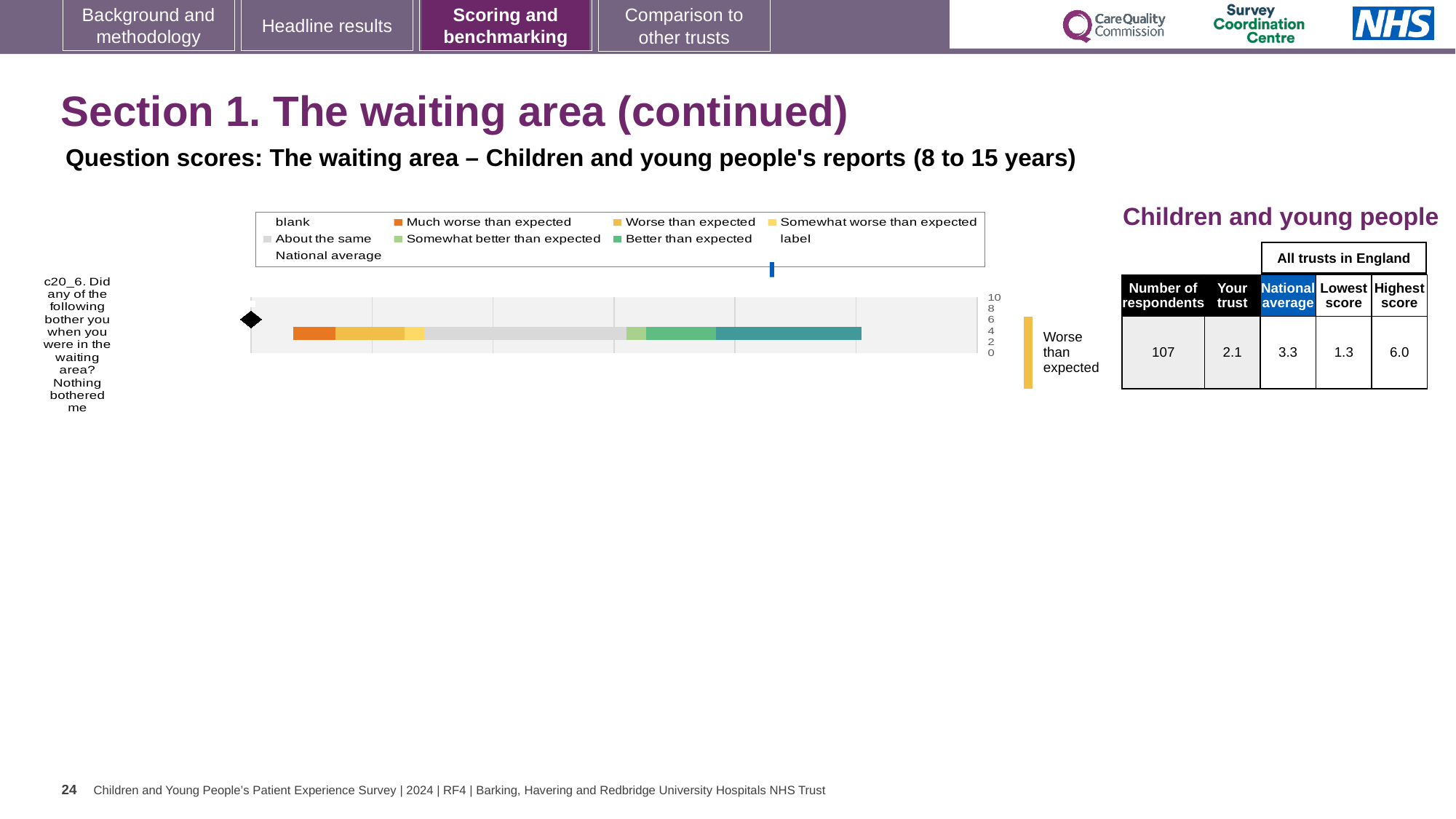
In the table next to the chart, what is the Number of respondents for question c20_6? 107 What benchmark label is shown to the right of the chart for question c20_6? Worse than expected What is the highest tick value shown on the chart's axis? 10 In the table next to the chart, which is larger for question c20_6: Your trust score or the National average? National average In the table next to the chart, what is the Highest score among all trusts in England for question c20_6? 6.0 In the table next to the chart, what is the National average score for question c20_6? 3.3 Which question is plotted in the chart? c20_6. Did any of the following bother you when you were in the waiting area? Nothing bothered me What kind of chart is shown on the slide? bar chart How many entries does the chart legend list? 9 In the table next to the chart, what is the score for Your trust on question c20_6? 2.1 How many question categories are plotted in the chart? 1 In the table next to the chart, what is the Lowest score among all trusts in England for question c20_6? 1.3